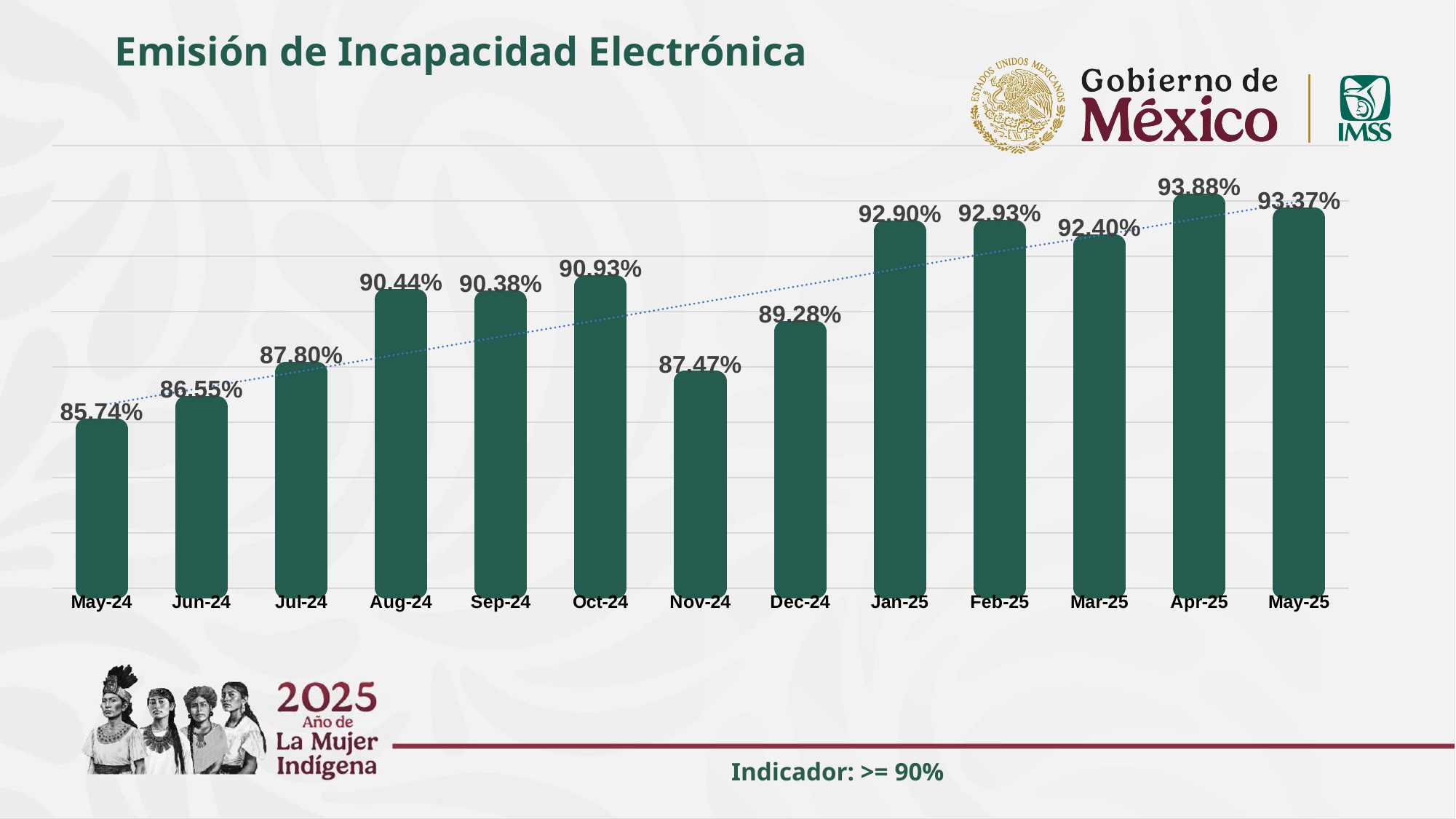
Which month has the highest value? Apr-25 What is the value for Aug-24? 90.44% Do the values generally rise or fall from May-24 to May-25? Rise What is the difference between the values for Jan-25 and Dec-24? 3.62 percentage points How many months are shown on the x axis? 13 Which is larger, the value for Oct-24 or the value for Nov-24? Oct-24 What is the value for May-25? 93.37% Which month has the lowest value? May-24 What is the value for Nov-24? 87.47% What kind of chart is shown on the slide? Bar chart What is the difference between the values for Apr-25 and May-24? 8.14 percentage points What is the title of the chart? Emisión de Incapacidad Electrónica